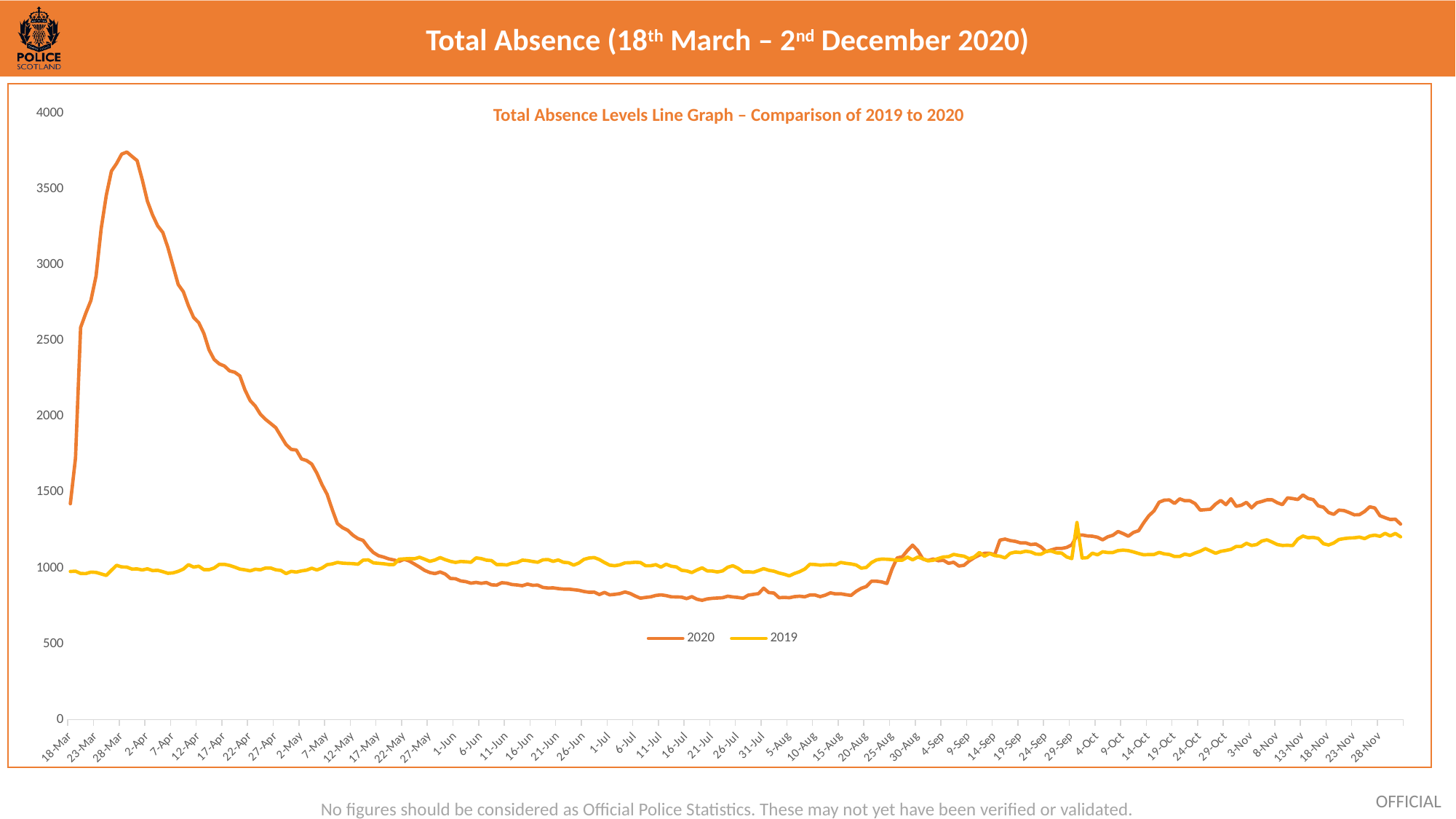
At 16-Jul, which series has the larger value, 2020 or 2019? 2019 How many series does the legend list? 2 What kind of chart is shown on the slide? line chart Is the value of the 2020 line at 16-Jul greater or less than 1000? less What are the two series named in the legend? 2020 and 2019 Which series reaches the highest value on the chart? 2020 Is the value of the 2019 line at 28-Nov greater or less than 1000? greater Does the 2020 line rise or fall between 28-Mar and 12-May? fall At 28-Mar, which series has the larger value, 2020 or 2019? 2020 Is the peak value of the 2020 line greater or less than 3500? greater What is the title printed inside the chart area? Total Absence Levels Line Graph – Comparison of 2019 to 2020